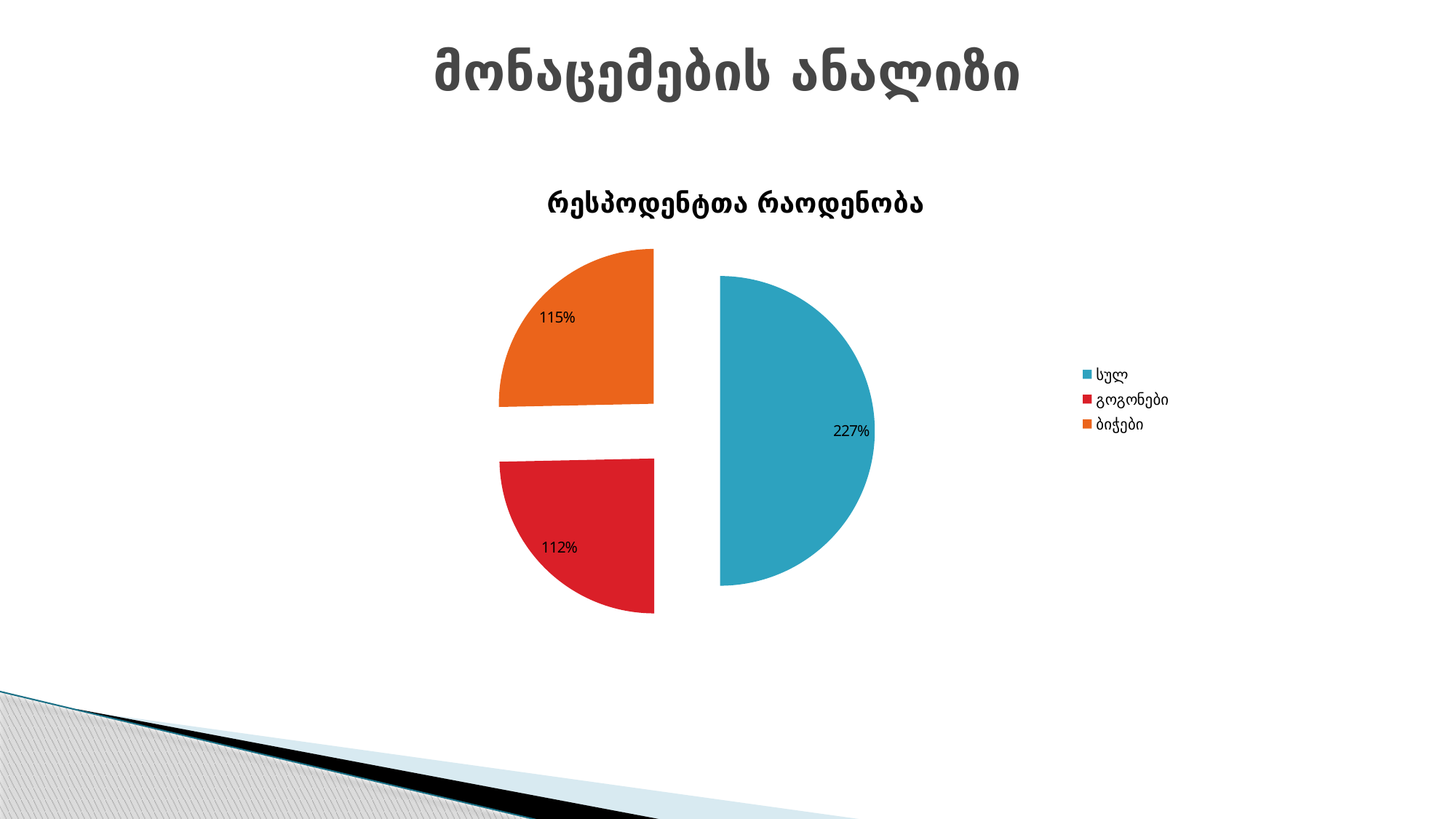
What value is shown for სულ in the pie chart? 227% Which category has the smallest slice in the pie chart? გოგონები What value is shown for ბიჭები in the pie chart? 115% How many slices does the pie chart have? 3 What is the difference between the value for ბიჭები and the value for გოგონები? 3% What is the difference between the value for სულ and the value for ბიჭები? 112% Which is larger, the value for ბიჭები or the value for გოგონები? ბიჭები How many entries does the legend list? 3 What kind of chart is shown on the slide? Pie chart What value is shown for გოგონები in the pie chart? 112% What is the title of the chart? რესპოდენტთა რაოდენობა Which category has the largest slice in the pie chart? სულ